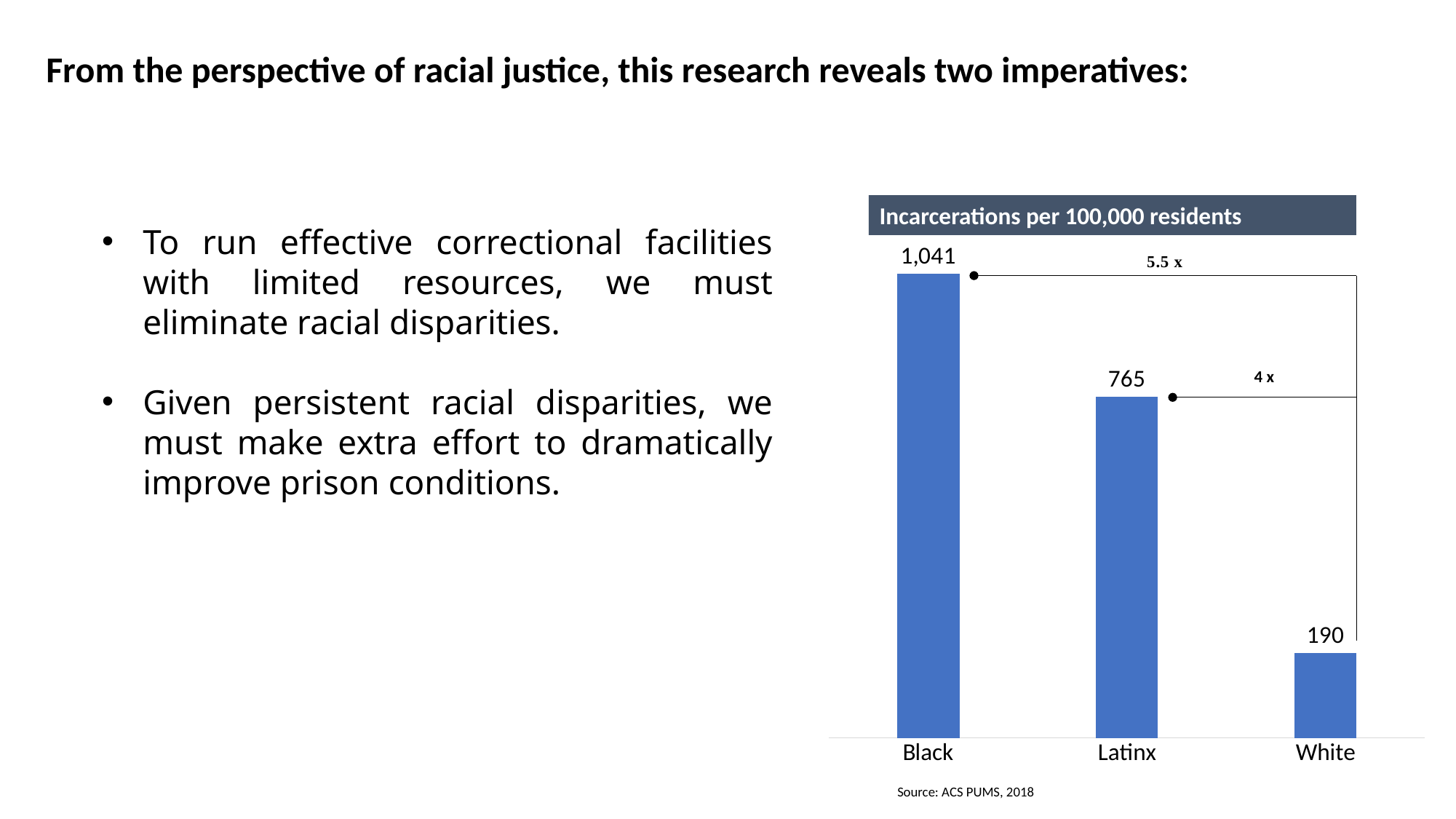
What is the value for White in the chart? 190 What kind of chart is shown on the slide? Bar chart Which category has the lowest incarceration rate per 100,000 residents? White What is the value for Latinx in the chart? 765 What is the difference between the values for Black and White? 851 How many categories are shown in the chart? 3 What is the difference between the values for Black and Latinx? 276 Which is larger, the value for Latinx or the value for White? Latinx What is the difference between the values for Latinx and White? 575 Which category has the highest incarceration rate per 100,000 residents? Black What is the value for Black in the chart? 1,041 What is the title of the chart? Incarcerations per 100,000 residents